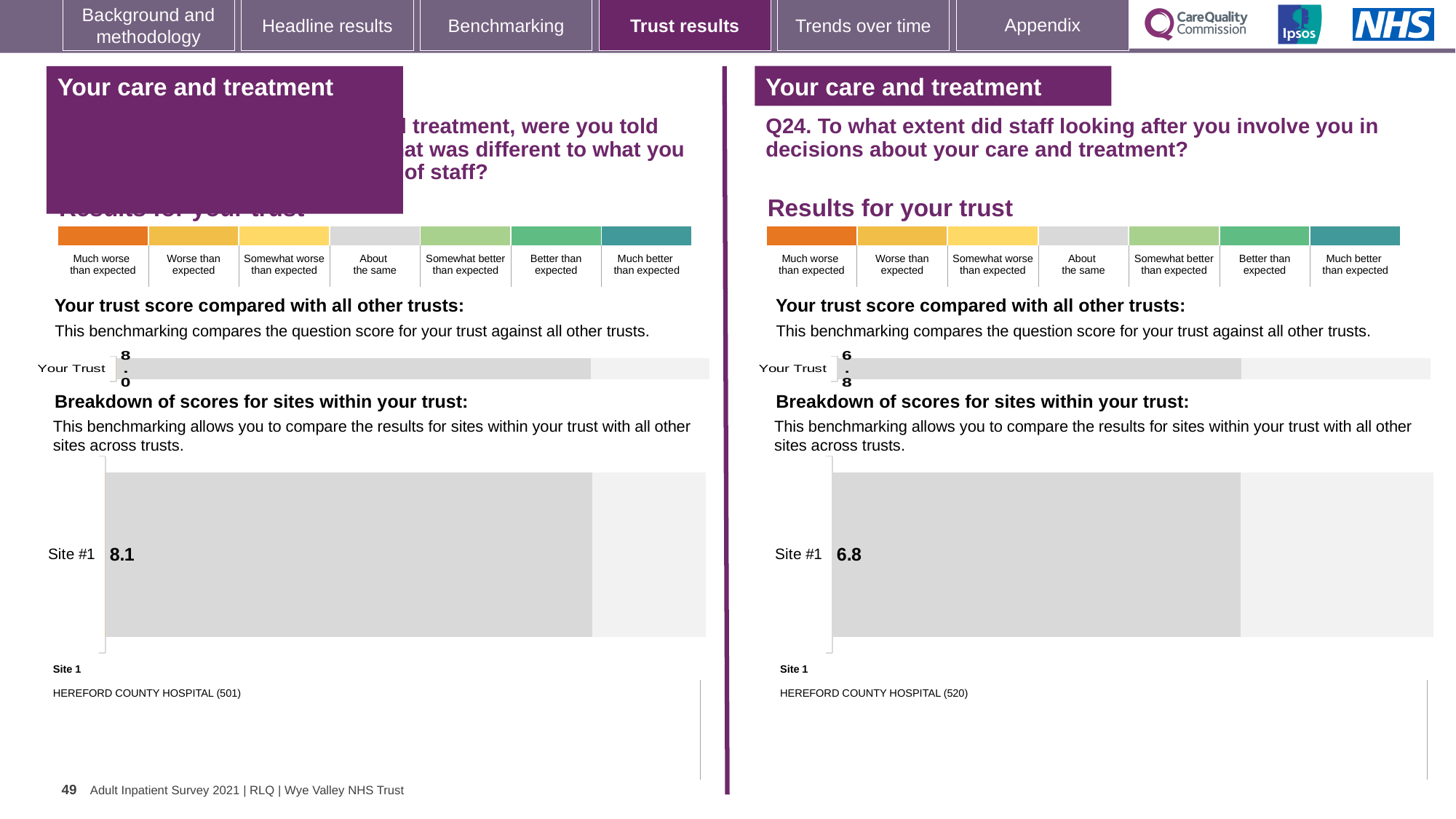
In the left 'Breakdown of scores for sites within your trust' chart, what is the score for Site #1? 8.1 What type of chart is used to show the Site #1 score on the right half of the slide? Bar chart What is the difference between the 'Your Trust' score on the left half and the 'Your Trust' score on the right half of the slide? 1.2 What is the difference between the Site #1 score in the left breakdown chart and the Site #1 score in the right breakdown chart? 1.3 Which is larger: the Site #1 score in the left breakdown chart or the Site #1 score in the right breakdown chart? The left chart (8.1) How many sites are shown in the right 'Breakdown of scores for sites within your trust' chart? 1 On the left half of the slide, what is the trust score shown for 'Your Trust'? 8.0 In the right 'Breakdown of scores for sites within your trust' chart (Q24), what is the score for Site #1? 6.8 Which site name is listed as Site 1 on the right half of the slide? HEREFORD COUNTY HOSPITAL (520) Which question number is shown on the right half of the slide? Q24 On the right half of the slide (Q24), what is the trust score shown for 'Your Trust'? 6.8 How many sites are shown in the left 'Breakdown of scores for sites within your trust' chart? 1